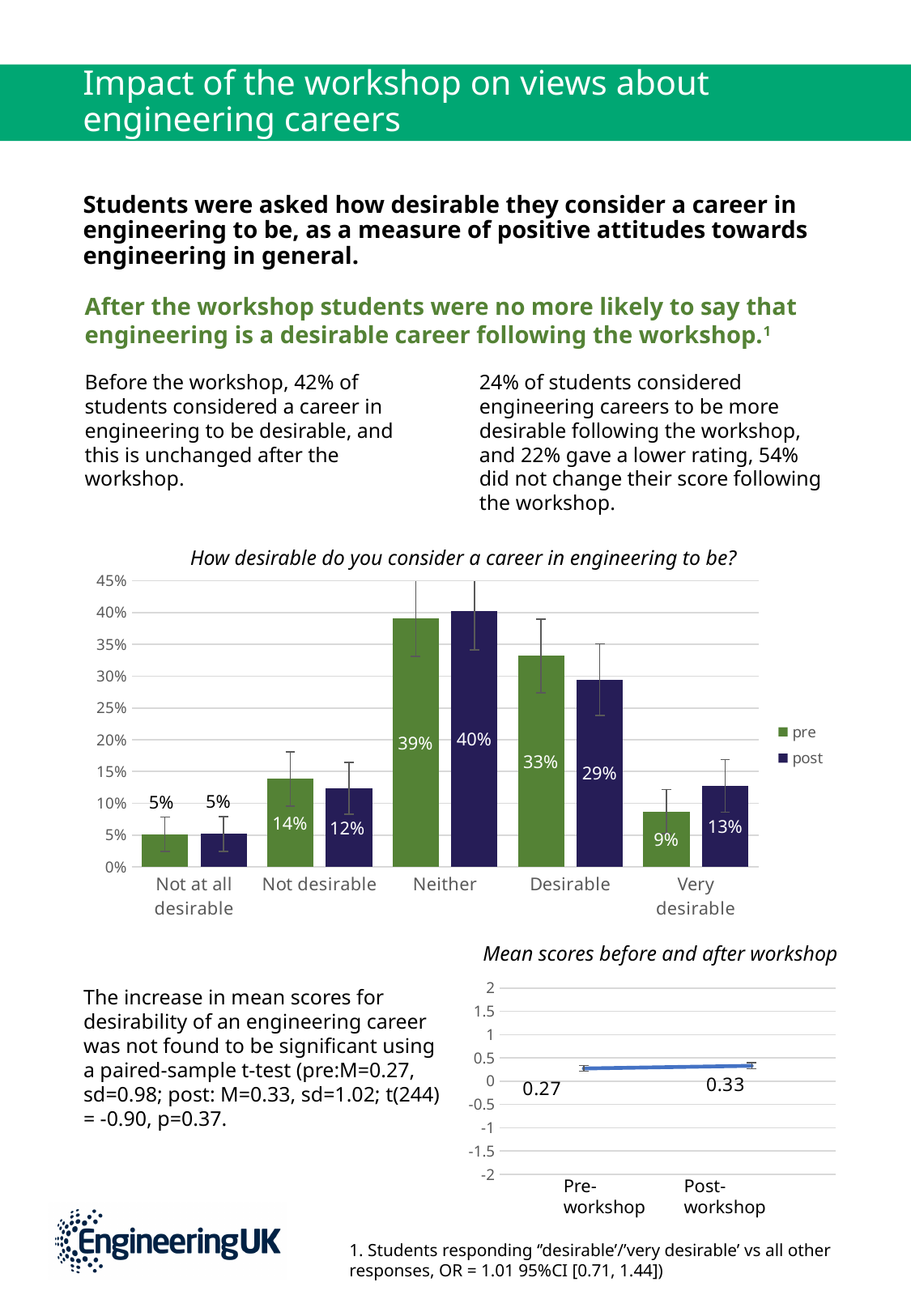
In the chart 'Mean scores before and after workshop', do the values rise or fall from Pre-workshop to Post-workshop? rise In the chart 'How desirable do you consider a career in engineering to be?', how many series does the legend list? 2 What type of chart is 'How desirable do you consider a career in engineering to be?'? bar chart In the chart 'How desirable do you consider a career in engineering to be?', what is the post value for Very desirable? 13% In the chart 'How desirable do you consider a career in engineering to be?', what is the difference between the pre and post values for Desirable? 4% In the chart 'How desirable do you consider a career in engineering to be?', which category has the lowest pre value? Not at all desirable In the chart 'How desirable do you consider a career in engineering to be?', which category has the highest post value? Neither In the chart 'How desirable do you consider a career in engineering to be?', what is the pre value for Neither? 39% In the chart 'Mean scores before and after workshop', what is the value for Post-workshop? 0.33 In the chart 'How desirable do you consider a career in engineering to be?', is the pre value for Not desirable larger or the post value for Not desirable? pre In the chart 'How desirable do you consider a career in engineering to be?', how many categories are shown on the x axis? 5 In the chart 'How desirable do you consider a career in engineering to be?', what is the post value for Desirable? 29%